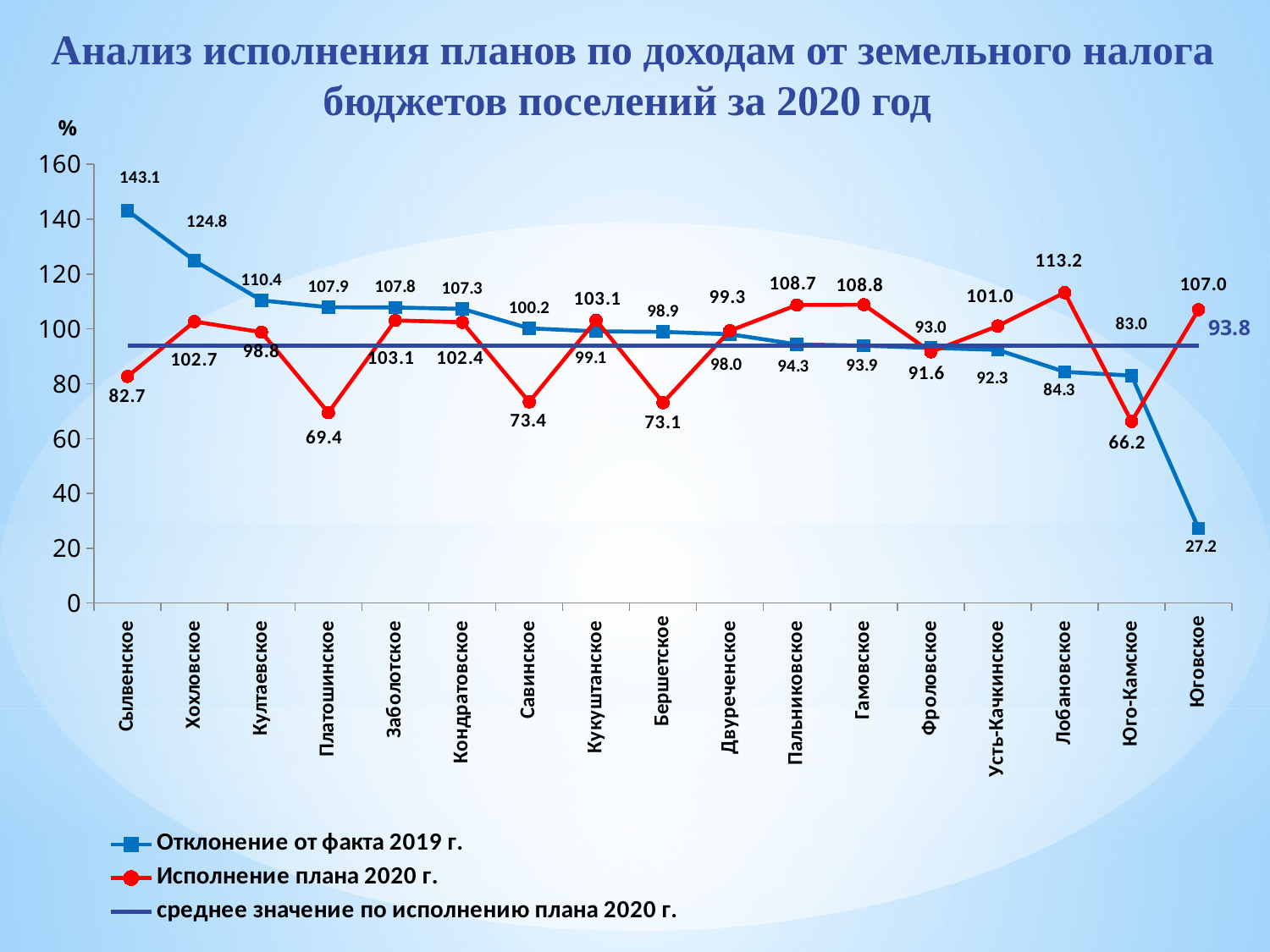
What type of chart is shown on the slide? Line chart Which settlement has the highest value for 'Исполнение плана 2020 г.'? Лобановское What is the value of 'Отклонение от факта 2019 г.' for Фроловское? 93.0 For Юговское, what is the difference between 'Исполнение плана 2020 г.' and 'Отклонение от факта 2019 г.'? 79.8 What is the value of 'Исполнение плана 2020 г.' for Платошинское? 69.4 For Лобановское, which is larger: 'Исполнение плана 2020 г.' or 'Отклонение от факта 2019 г.'? Исполнение плана 2020 г. How many entries does the legend list? 3 Which settlement has the lowest value for 'Исполнение плана 2020 г.'? Юго-Камское For Сылвенское, what is the difference between 'Отклонение от факта 2019 г.' and 'Исполнение плана 2020 г.'? 60.4 How many settlements are shown on the x axis? 17 What is the value of 'Отклонение от факта 2019 г.' for Сылвенское? 143.1 Which settlement has the lowest value for 'Отклонение от факта 2019 г.'? Юговское